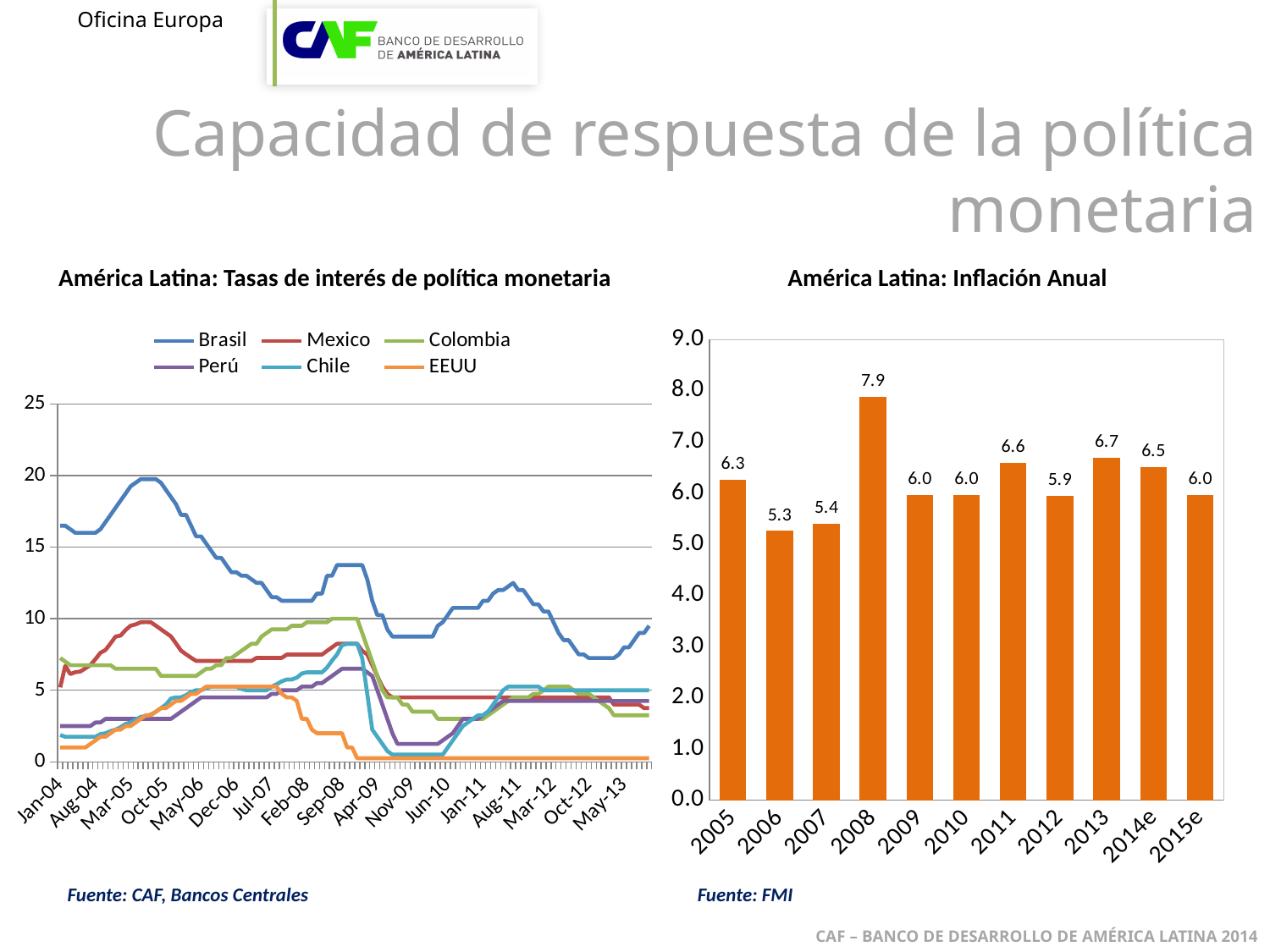
What kind of chart is 'América Latina: Tasas de interés de política monetaria'? Line chart In the 'América Latina: Inflación Anual' chart, what is the value for 2008? 7.9 In the 'América Latina: Inflación Anual' chart, what is the difference between the values for 2008 and 2006? 2.6 What kind of chart is 'América Latina: Inflación Anual'? Bar chart In the 'América Latina: Inflación Anual' chart, what is the value for 2014e? 6.5 In the 'América Latina: Inflación Anual' chart, which is larger, the value for 2011 or the value for 2012? 2011 In the 'América Latina: Inflación Anual' chart, which year has the lowest value? 2006 In the 'América Latina: Tasas de interés de política monetaria' chart, which series is shown in orange? EEUU In the 'América Latina: Inflación Anual' chart, how many years are shown on the x axis? 11 In the 'América Latina: Tasas de interés de política monetaria' chart, is the value for Brasil at Oct-05 greater or less than 15? greater How many series does the legend of the 'América Latina: Tasas de interés de política monetaria' chart list? 6 In the 'América Latina: Inflación Anual' chart, which year has the highest value? 2008